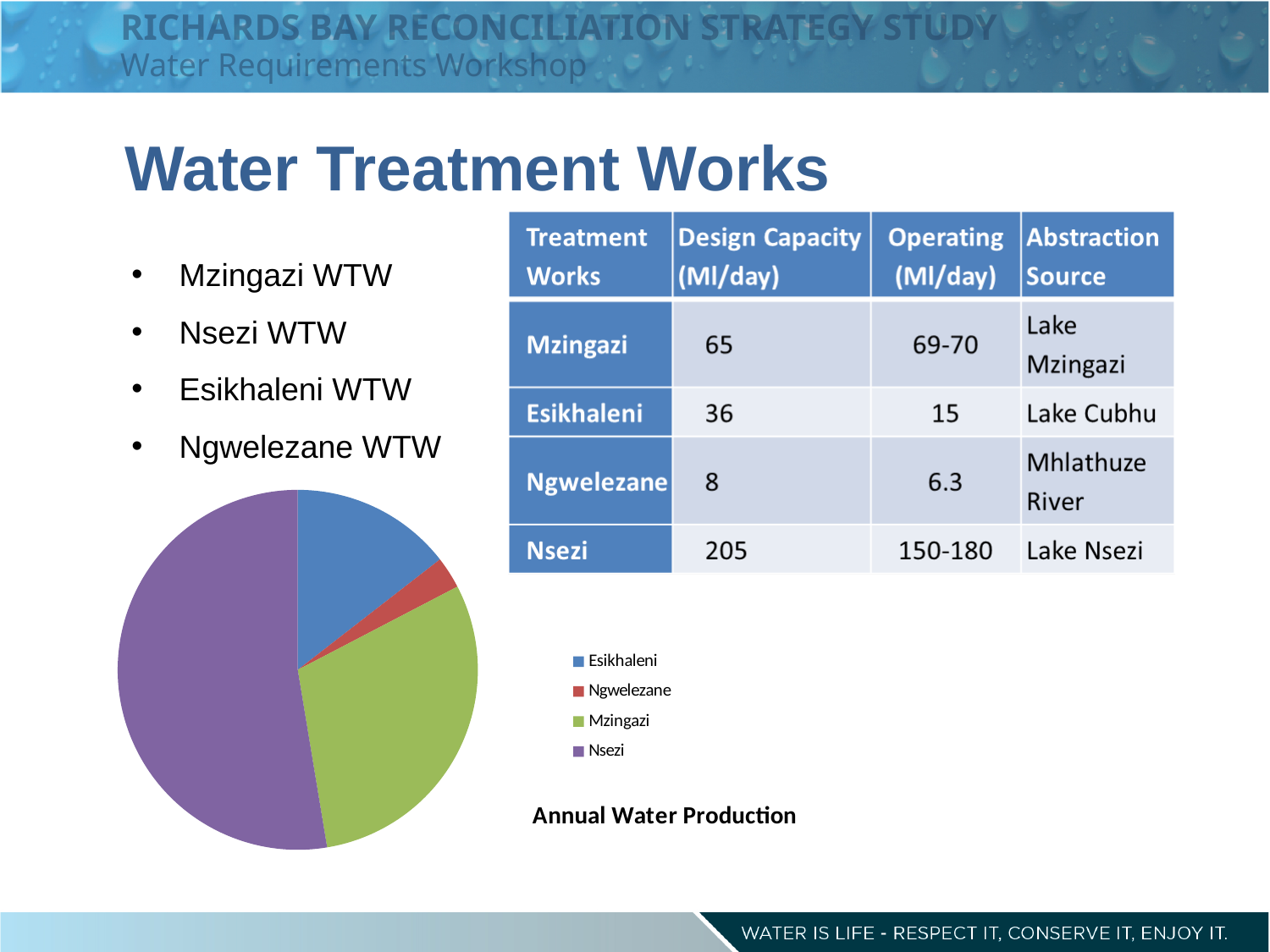
Which treatment works has the smallest slice of the Annual Water Production pie chart? Ngwelezane In the pie chart, which slice is larger: Esikhaleni or Ngwelezane? Esikhaleni In the pie chart, which slice is larger: Mzingazi or Esikhaleni? Mzingazi How many entries does the pie chart's legend list? 4 What is the title of the pie chart? Annual Water Production In the pie chart, which slice is larger: Nsezi or Mzingazi? Nsezi Which treatment works has the largest slice of the Annual Water Production pie chart? Nsezi How many slices does the pie chart have? 4 Which colour represents Nsezi in the pie chart? purple What kind of chart is shown on the slide? pie chart